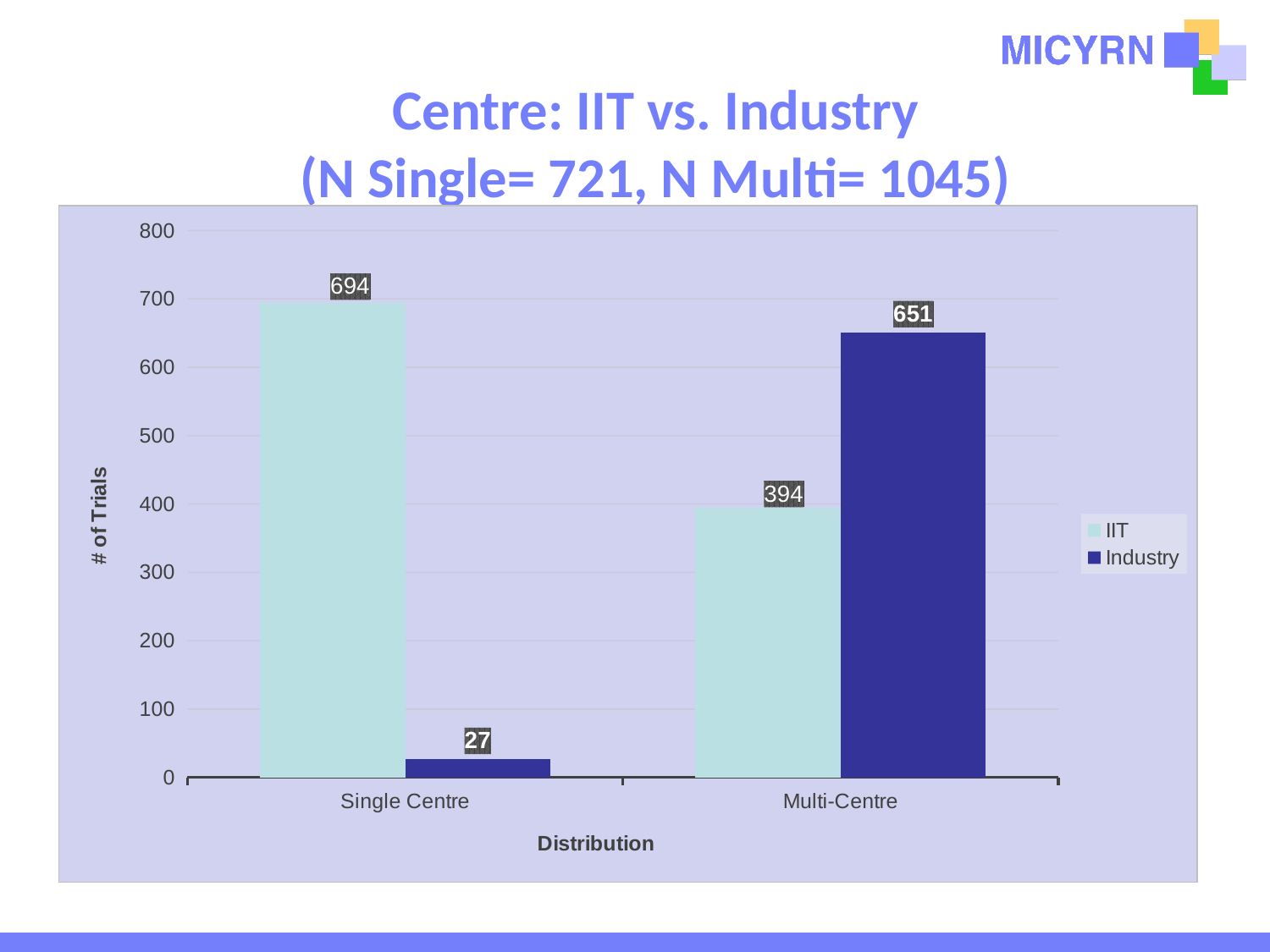
What is the number of IIT trials for Multi-Centre? 394 What is the difference between Industry and IIT trials for Multi-Centre? 257 For Multi-Centre, which series has more trials, IIT or Industry? Industry How many series does the legend list? 2 What is the number of Industry trials for Single Centre? 27 Which category has the highest number of Industry trials? Multi-Centre What is the number of Industry trials for Multi-Centre? 651 What is the number of IIT trials for Single Centre? 694 Which category has the lowest number of IIT trials? Multi-Centre What is the difference between IIT and Industry trials for Single Centre? 667 What is the label of the y axis? # of Trials What kind of chart is shown on the slide? Bar chart